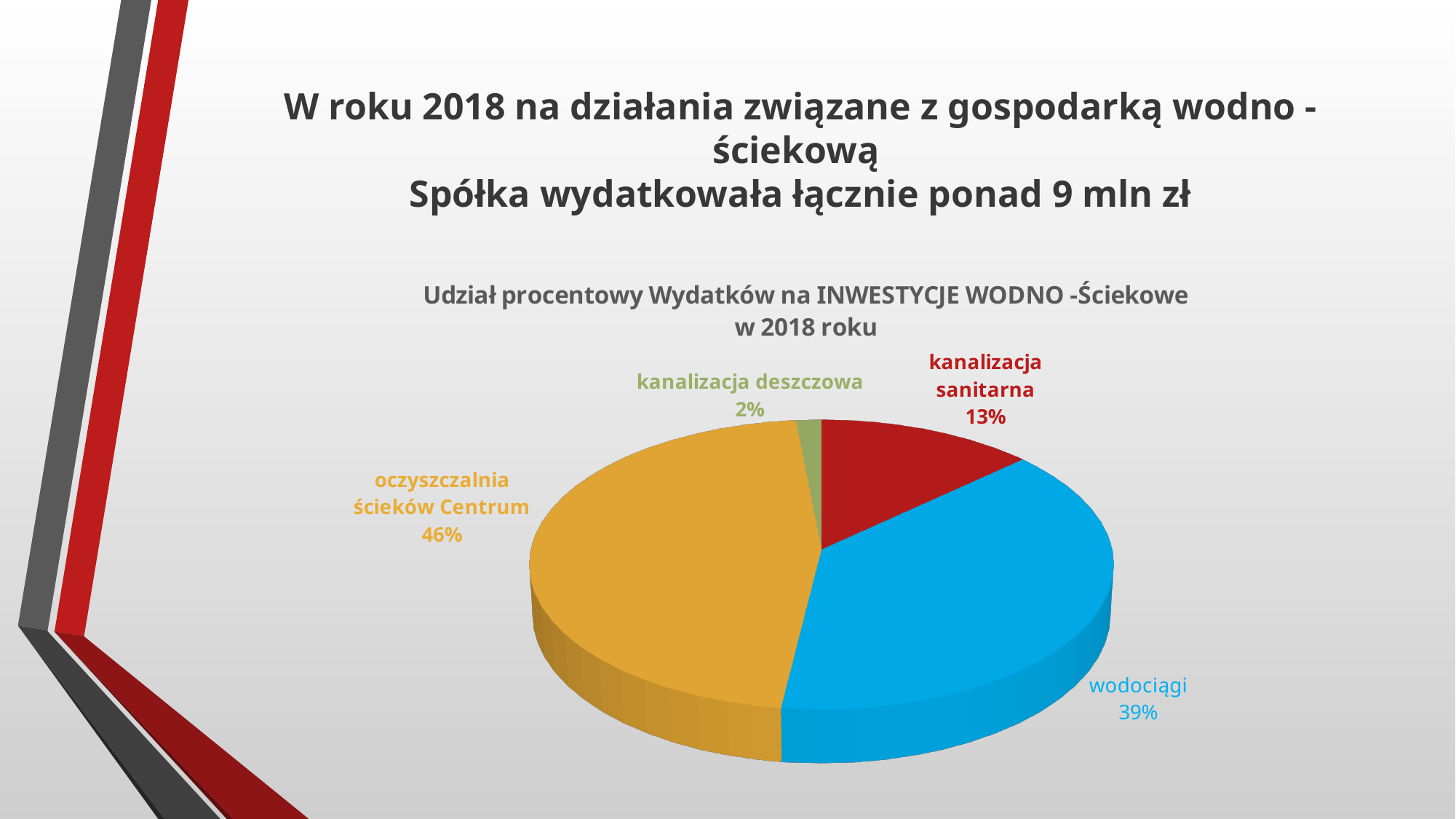
Which is larger, the share for 'wodociągi' or the share for 'kanalizacja sanitarna'? wodociągi What is the difference in percentage points between 'kanalizacja sanitarna' and 'kanalizacja deszczowa'? 11 percentage points What share of the pie does 'kanalizacja deszczowa' represent? 2% What is the title of the chart? Udział procentowy Wydatków na INWESTYCJE WODNO -Ściekowe w 2018 roku Which category has the smallest share of the pie? kanalizacja deszczowa What share of the pie does 'oczyszczalnia ścieków Centrum' represent? 46% How many categories are shown in the pie chart? 4 What share of the pie does 'kanalizacja sanitarna' represent? 13% What is the difference in percentage points between 'oczyszczalnia ścieków Centrum' and 'wodociągi'? 7 percentage points Which category has the largest share of the pie? oczyszczalnia ścieków Centrum What kind of chart is shown on the slide? Pie chart